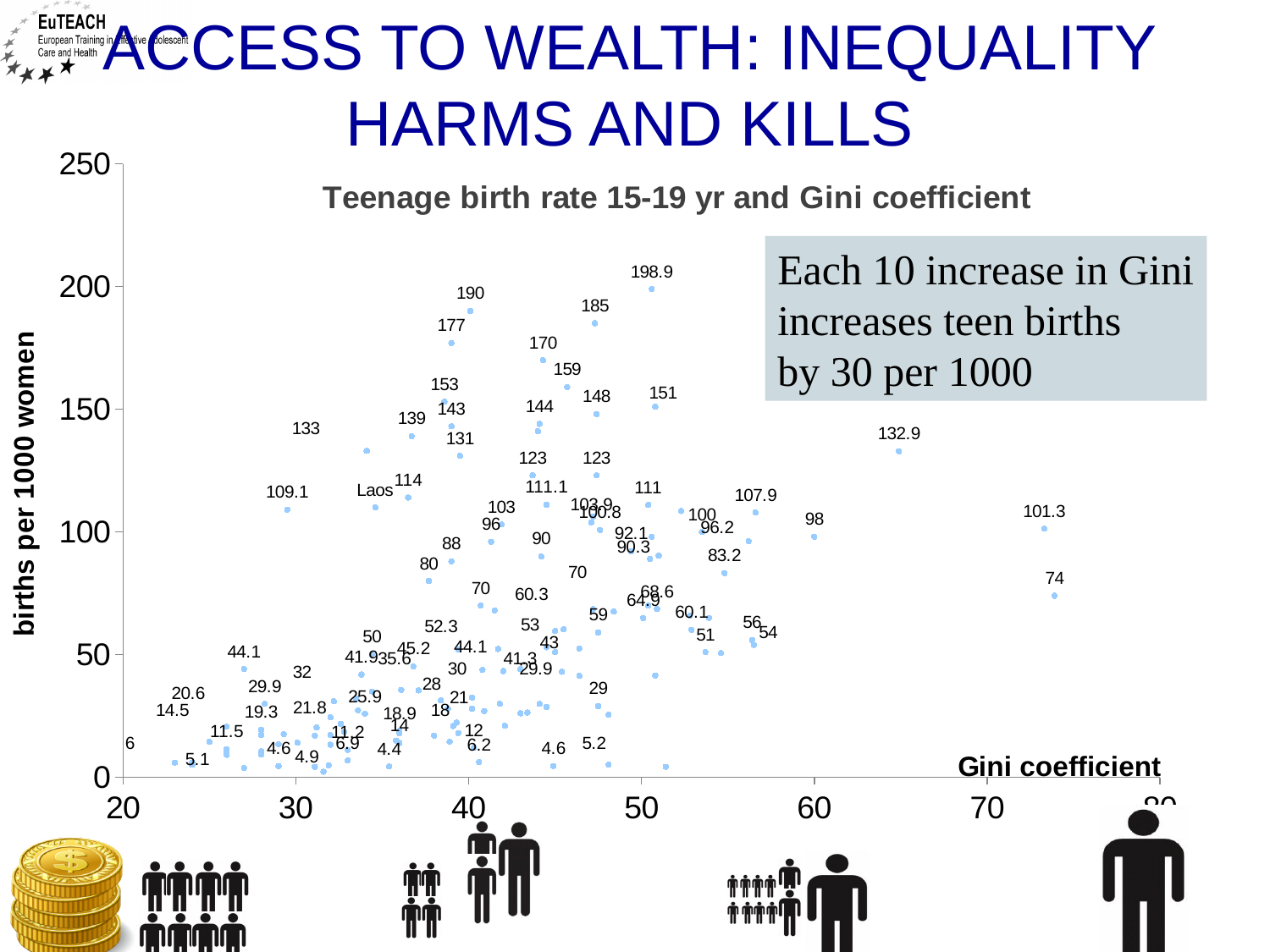
What is the highest value shown on the y axis? 250 What type of chart is shown on the slide? scatter chart Which is larger, the point labeled 132.9 or the point labeled 101.3? 132.9 What is the title of the chart? Teenage birth rate 15-19 yr and Gini coefficient Which is larger, the point labeled 190 or the point labeled 185? 190 Is the value of the lowest point at a Gini coefficient of about 74 greater or less than 100? less Is the value of the point at a Gini coefficient of about 65 greater or less than 100? greater What is the highest teenage birth rate value labeled on the chart? 198.9 Do teenage birth rates generally rise or fall as the Gini coefficient increases along the x axis? rise What is the difference between the points labeled 185 and 177? 8 What is the difference between the two highest labeled values, 198.9 and 190? 8.9